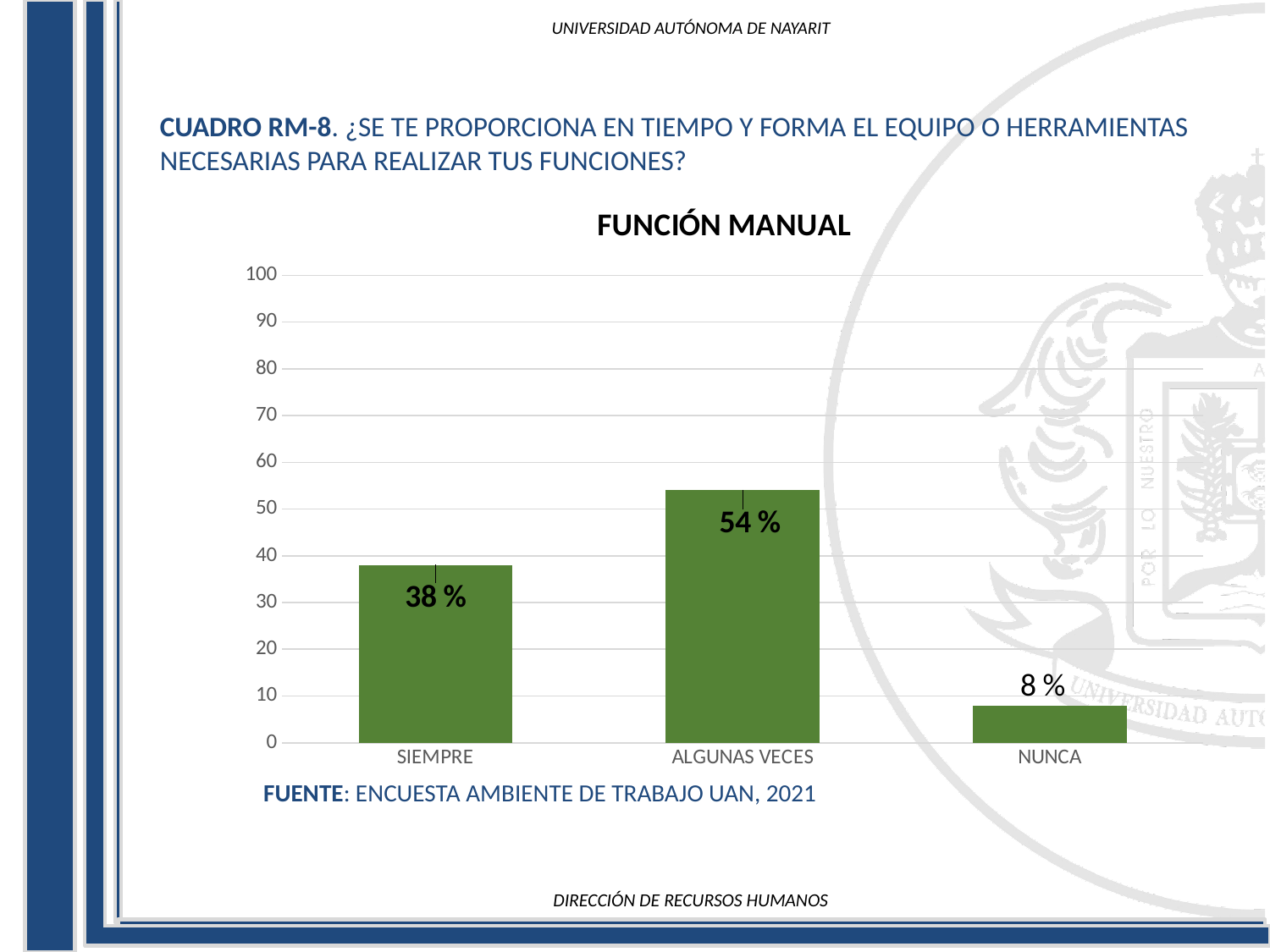
What is the value for NUNCA? 8 % What is the value for ALGUNAS VECES? 54 % Which category has the lowest value? NUNCA Is the value for ALGUNAS VECES greater or less than 50? greater How many categories are shown on the x axis? 3 Which is larger, the value for SIEMPRE or the value for NUNCA? SIEMPRE What kind of chart is shown on the slide? bar chart What is the difference between the values for ALGUNAS VECES and SIEMPRE? 16 % Which category has the highest value? ALGUNAS VECES What is the title of the chart? FUNCIÓN MANUAL What is the difference between the values for SIEMPRE and NUNCA? 30 % What is the value for SIEMPRE? 38 %